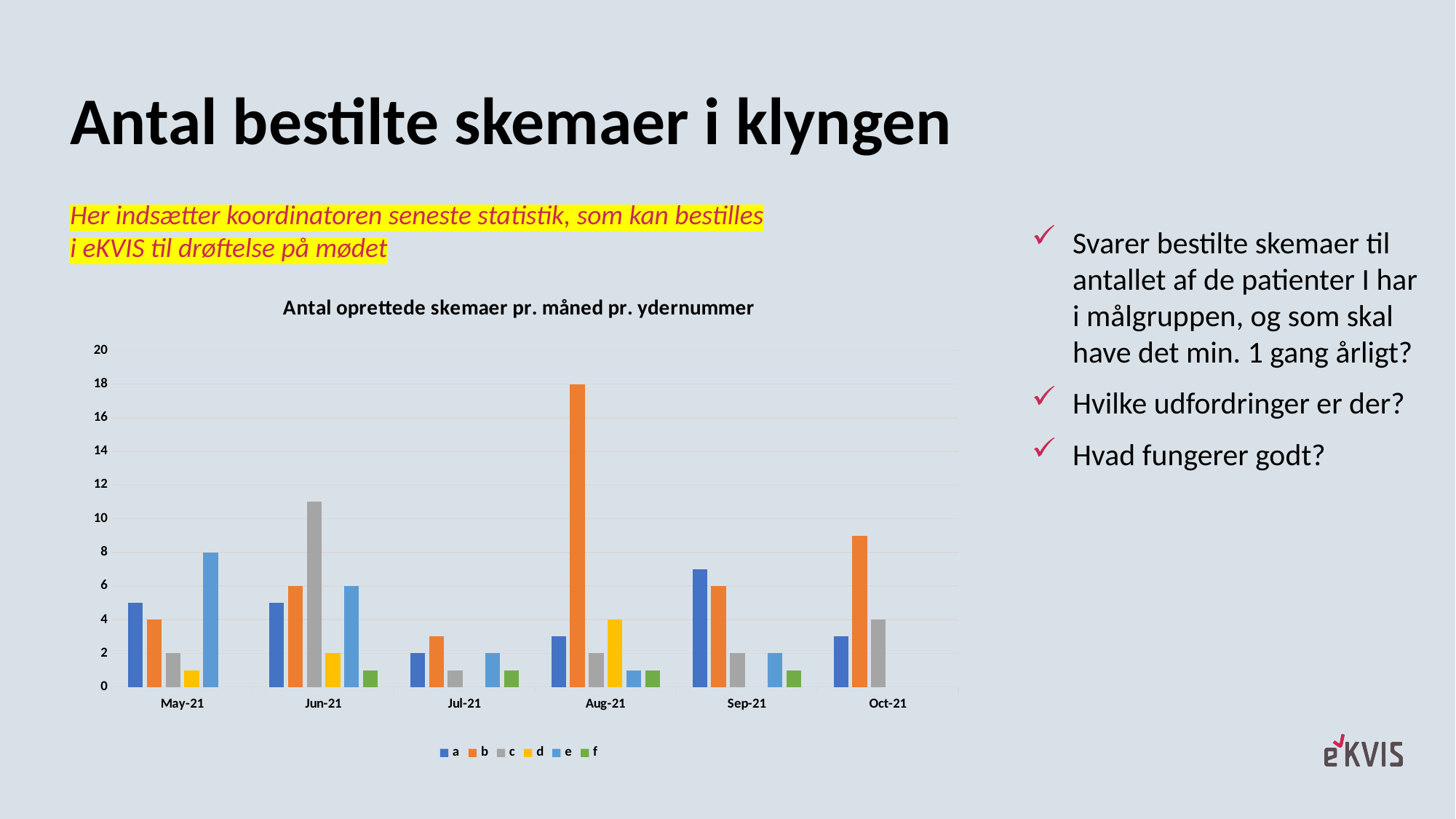
What is the difference between series b in Aug-21 and series b in Sep-21? 12 Is the value for series c in Jun-21 greater or less than 10? greater How many series does the chart legend list? 6 What is the title of the chart? Antal oprettede skemaer pr. måned pr. ydernummer What is the value for series c in Oct-21? 4 What kind of chart is shown on the slide? bar chart In which month does series b reach its highest value? Aug-21 Which is larger in Sep-21, series a or series b? series a What is the value for series b in Aug-21? 18 What is the value for series d in Aug-21? 4 How many months are shown on the x axis of the chart? 6 What is the value for series e in May-21? 8